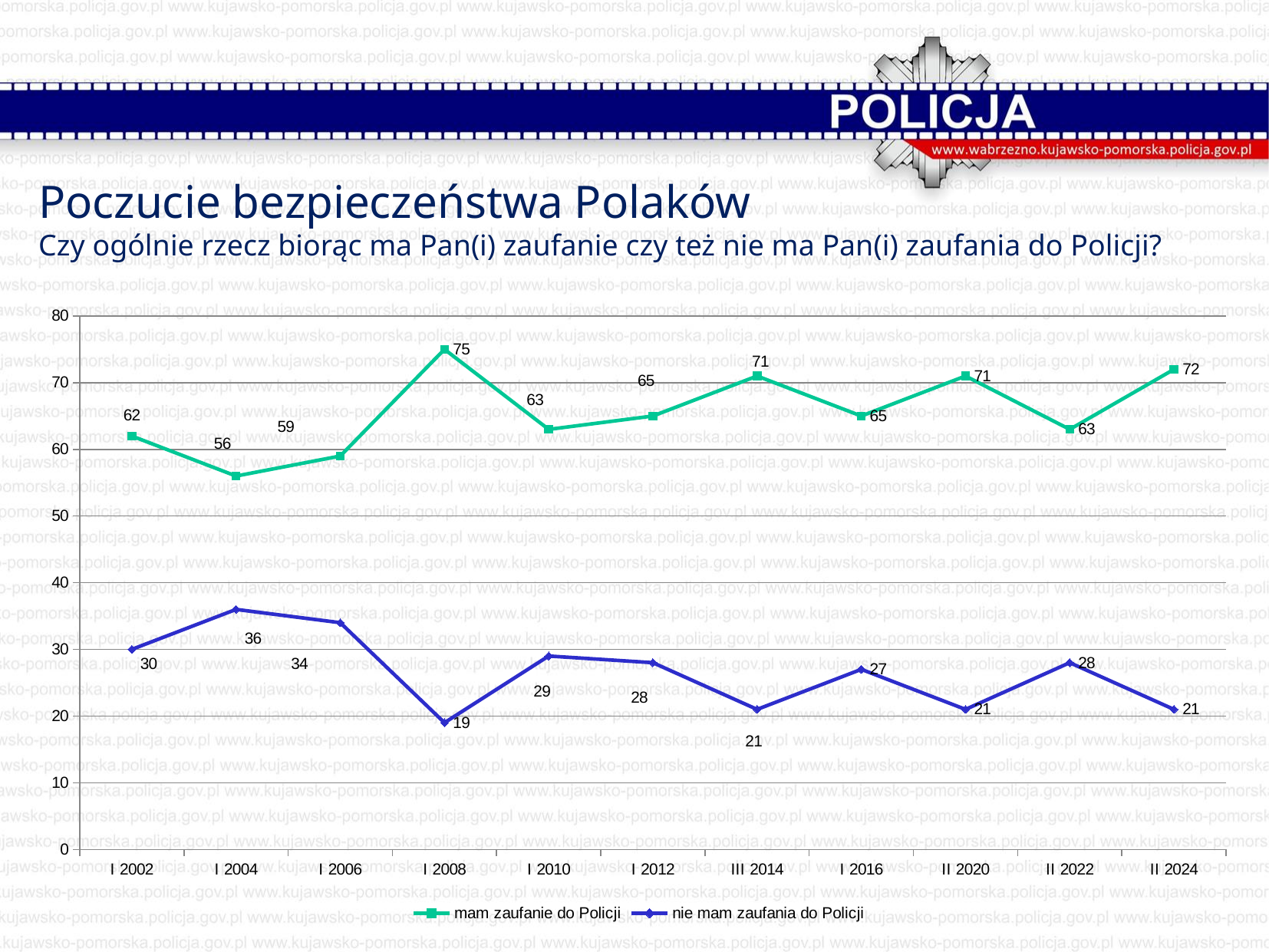
What is the value of 'mam zaufanie do Policji' for I 2008? 75 Which is larger for I 2002: 'mam zaufanie do Policji' or 'nie mam zaufania do Policji'? mam zaufanie do Policji How many series does the legend list? 2 What type of chart is shown on the slide? line chart In which period does 'nie mam zaufania do Policji' reach its highest value? I 2004 What is the value of 'nie mam zaufania do Policji' for II 2024? 21 What is the difference between 'mam zaufanie do Policji' and 'nie mam zaufania do Policji' in II 2024? 51 What is the title of the chart's question shown on the slide? Czy ogólnie rzecz biorąc ma Pan(i) zaufanie czy też nie ma Pan(i) zaufania do Policji? Is the value of 'mam zaufanie do Policji' for I 2004 greater or less than 60? less In which period does 'mam zaufanie do Policji' reach its highest value? I 2008 In which period does 'mam zaufanie do Policji' have its lowest value? I 2004 How many time points are plotted along the x axis? 11